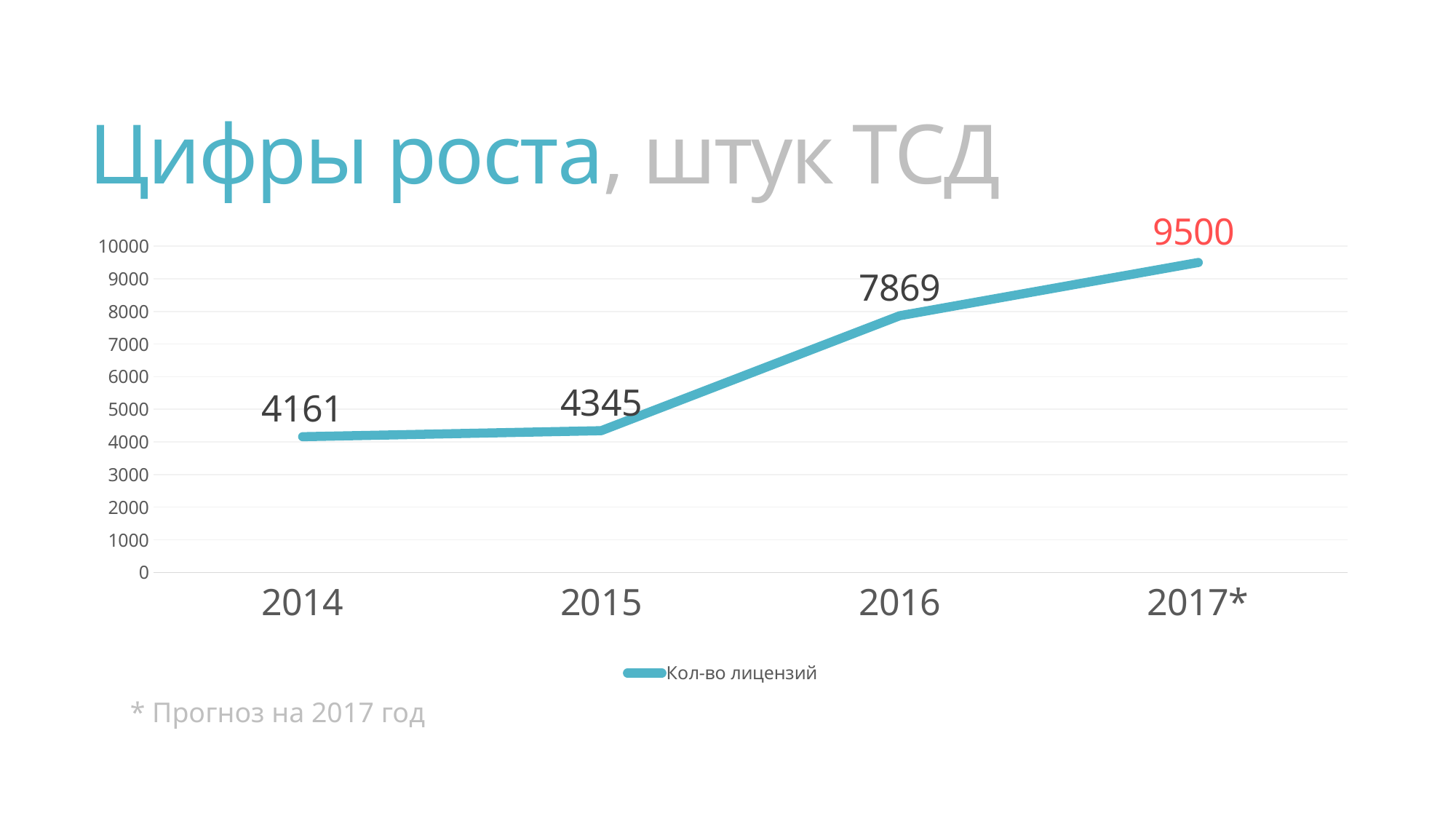
Which year has the lowest value? 2014 Which year has the highest value? 2017* What kind of chart is shown on the slide? line chart What is the difference between the values for 2016 and 2015? 3524 How many series does the legend list? 1 What is the forecast value for 2017*? 9500 What is the value for 2014? 4161 Which is larger, the value for 2015 or the value for 2016? 2016 What is the value for 2016? 7869 What is the difference between the values for 2017* and 2016? 1631 Do the values rise or fall from 2014 to 2017*? rise How many data points are plotted on the chart? 4